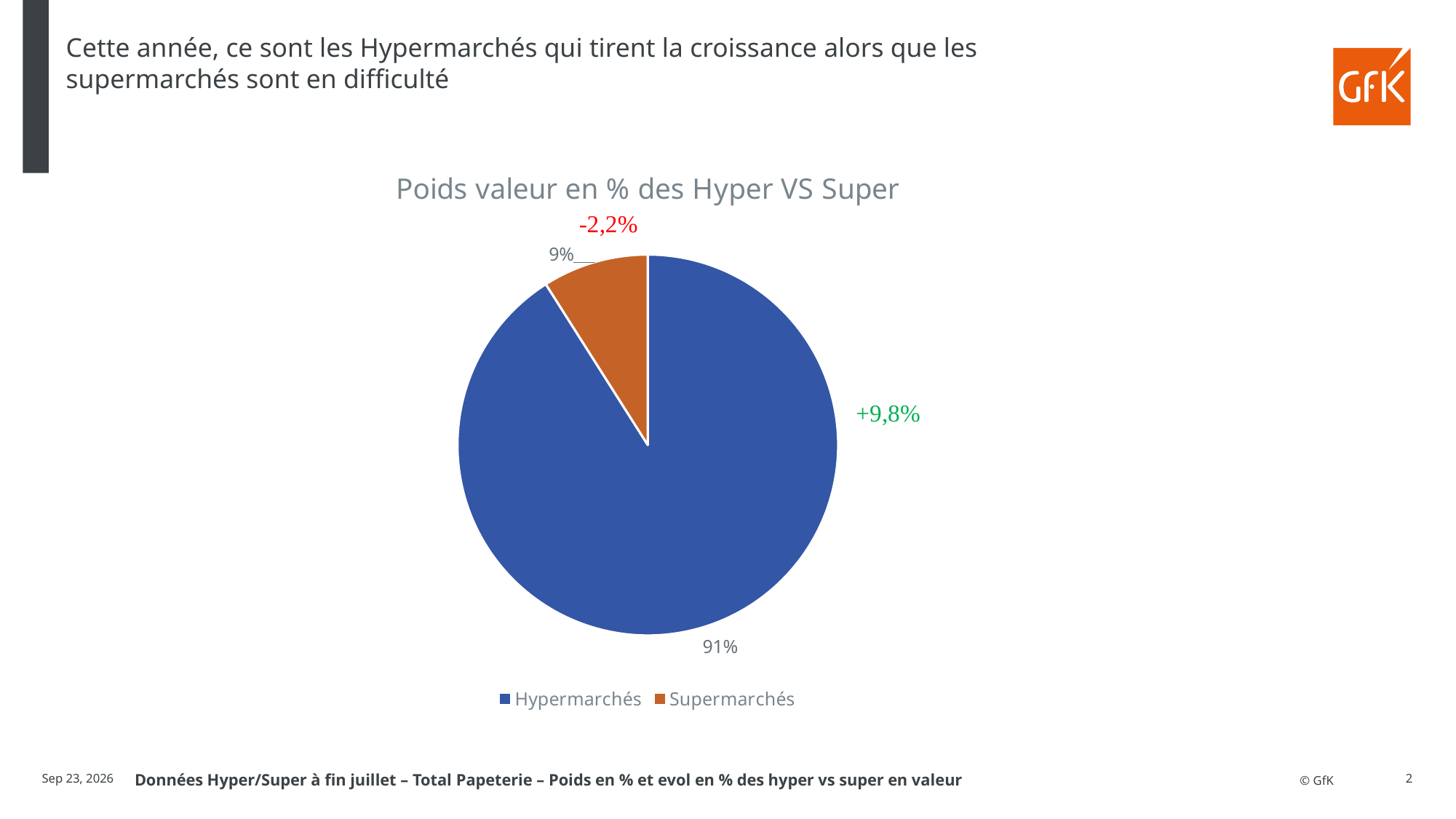
How many slices does the pie chart have? 2 What evolution figure is annotated next to the Hypermarchés slice? +9,8% What share of the pie does Hypermarchés hold? 91% Which category has the smallest slice of the pie? Supermarchés Which category has the largest slice of the pie? Hypermarchés What is the difference in percentage points between the Hypermarchés and Supermarchés slices? 82 What kind of chart is shown on the slide? pie chart How many entries does the legend list? 2 What share of the pie does Supermarchés hold? 9% What is the title of the chart? Poids valeur en % des Hyper VS Super Which slice is larger, Hypermarchés or Supermarchés? Hypermarchés What evolution figure is annotated next to the Supermarchés slice? -2,2%